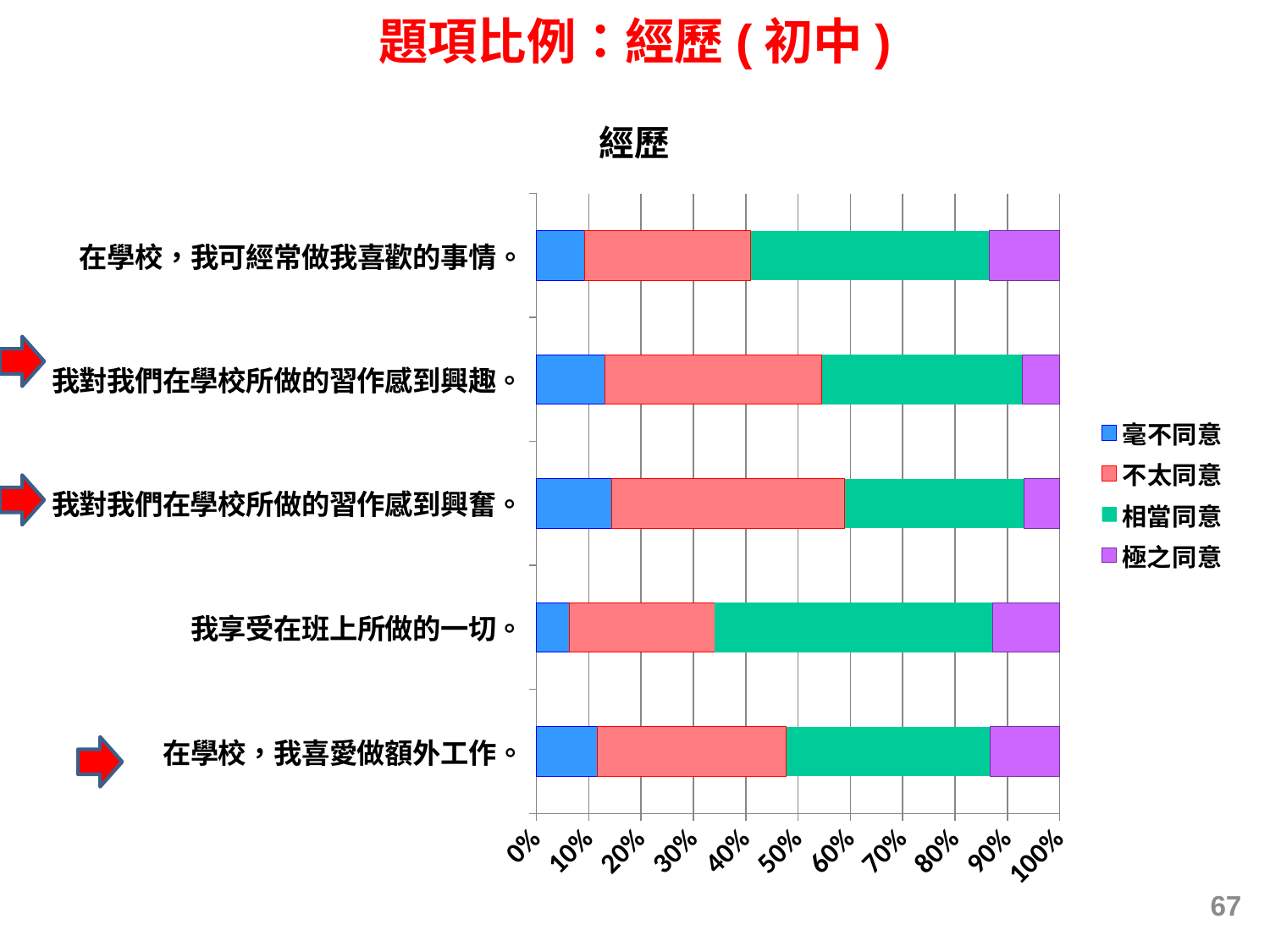
Is the 相當同意 share for 我享受在班上所做的一切。 greater or less than 40%? greater How many series does the legend list? 4 Which statement has the largest 相當同意 share? 我享受在班上所做的一切。 Is the 毫不同意 share for 我享受在班上所做的一切。 greater or less than 10%? less Is the 極之同意 share for 我對我們在學校所做的習作感到興趣。 greater or less than 10%? less How many categories (statements) are plotted in the chart? 5 Which has the larger 毫不同意 share: 我享受在班上所做的一切。 or 我對我們在學校所做的習作感到興奮。? 我對我們在學校所做的習作感到興奮。 What kind of chart is shown on the slide? Stacked bar chart Which legend entry is shown in purple? 極之同意 What is the title of the chart? 經歷